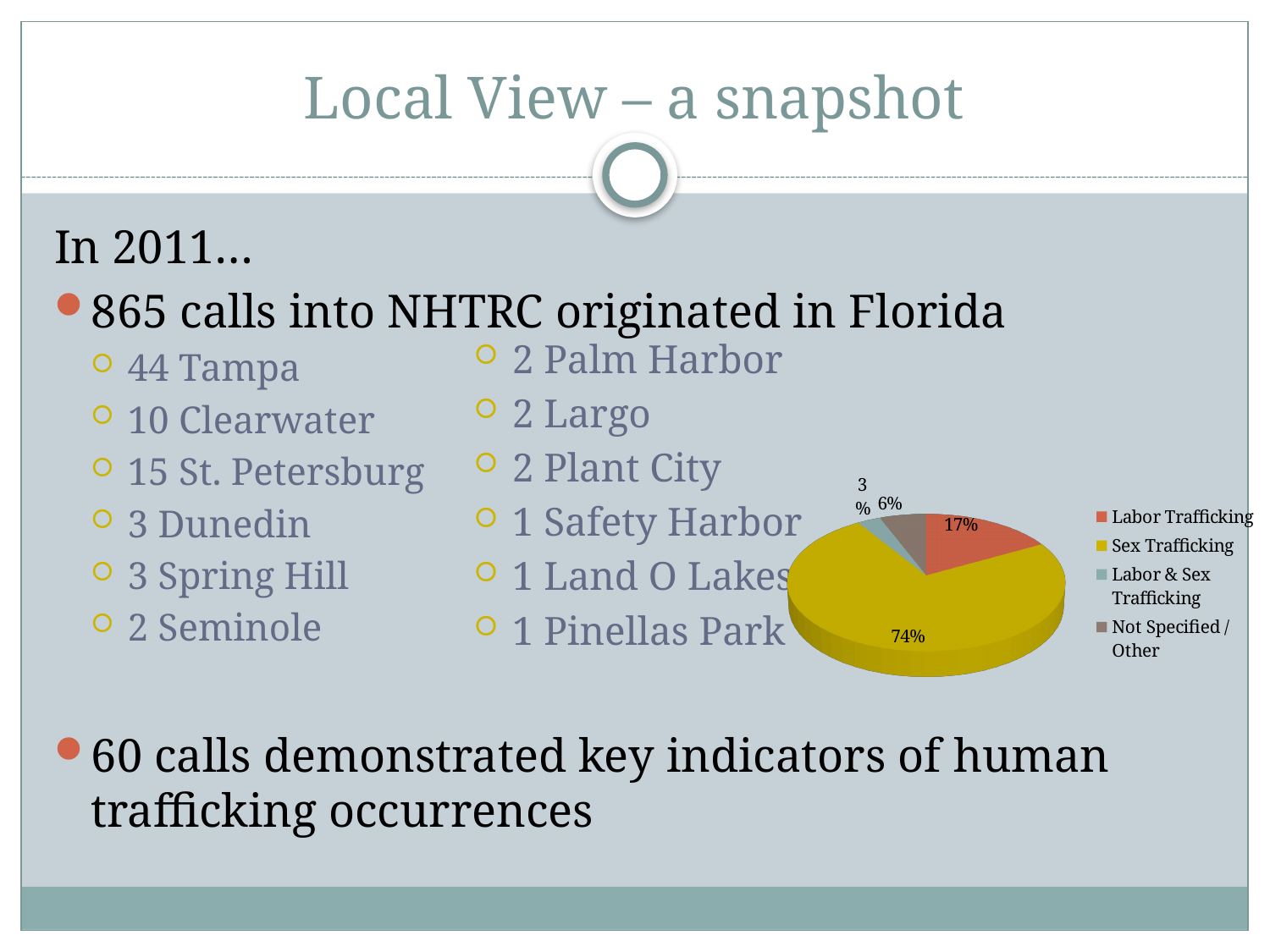
What share of the pie does Labor & Sex Trafficking represent? 3% What share of the pie does Not Specified / Other represent? 6% What share of the pie does Sex Trafficking represent? 74% Which category has the smallest slice of the pie? Labor & Sex Trafficking What is the difference in percentage points between Sex Trafficking and Labor Trafficking? 57 How many entries does the legend list? 4 What kind of chart is shown on the slide? pie chart Which is larger, the Labor Trafficking slice or the Not Specified / Other slice? Labor Trafficking What colour is the Sex Trafficking slice in the pie chart? yellow Which category has the largest slice of the pie? Sex Trafficking How many slices does the pie chart have? 4